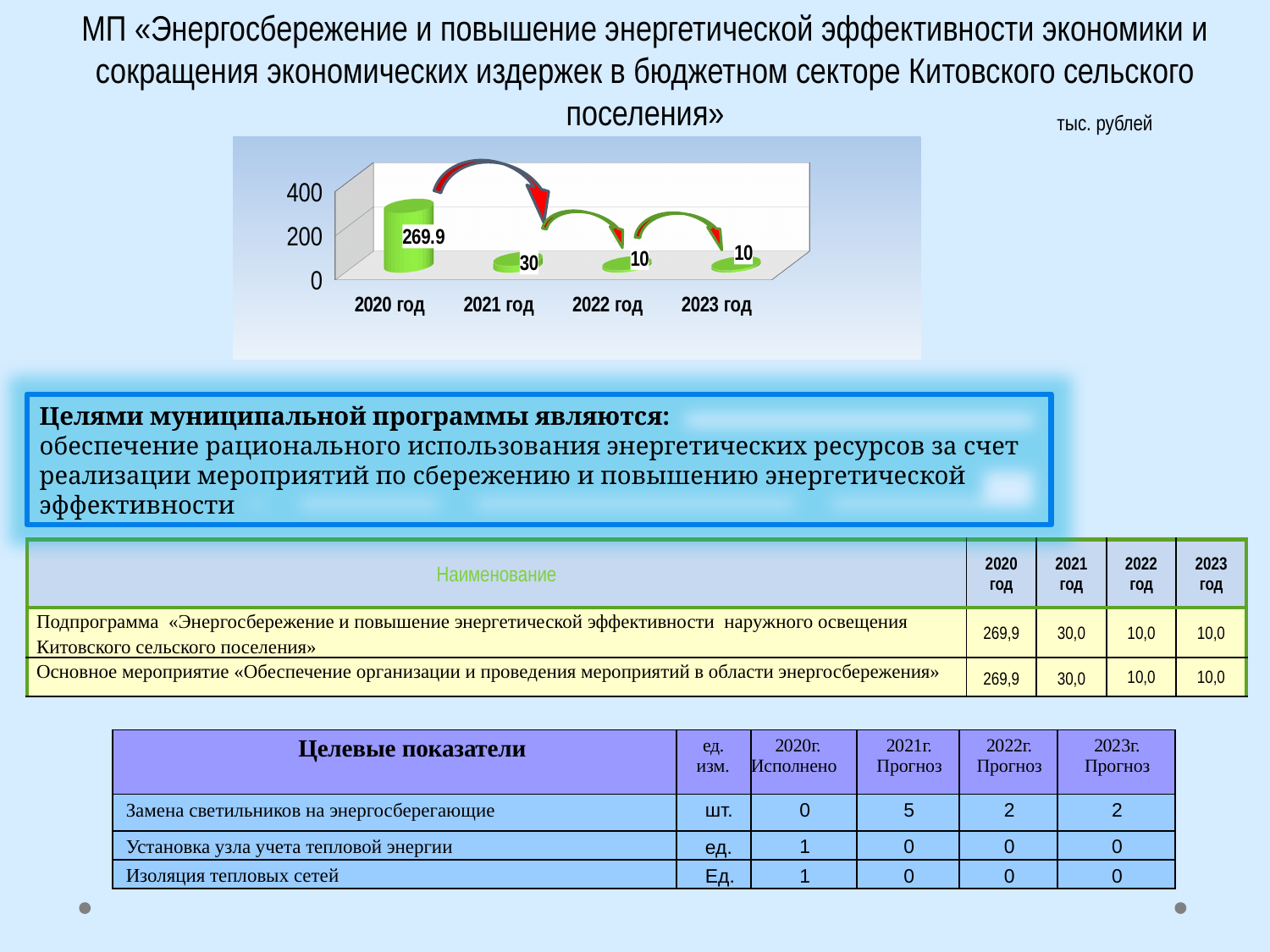
What kind of chart is shown on the slide? bar chart What is the difference between the values for 2021 год and 2022 год? 20 Which year has the highest value on the chart? 2020 год What is the value shown for 2022 год on the chart? 10 What is the value shown for 2023 год on the chart? 10 What is the difference between the values for 2020 год and 2021 год? 239.9 How many years are shown on the x axis of the chart? 4 What is the value shown for 2020 год on the chart? 269.9 What is the value shown for 2021 год on the chart? 30 Do the values on the chart rise or fall from 2020 год to 2023 год? fall Which is larger, the value for 2020 год or the value for 2021 год? 2020 год Is the value for 2020 год greater or less than 200? greater